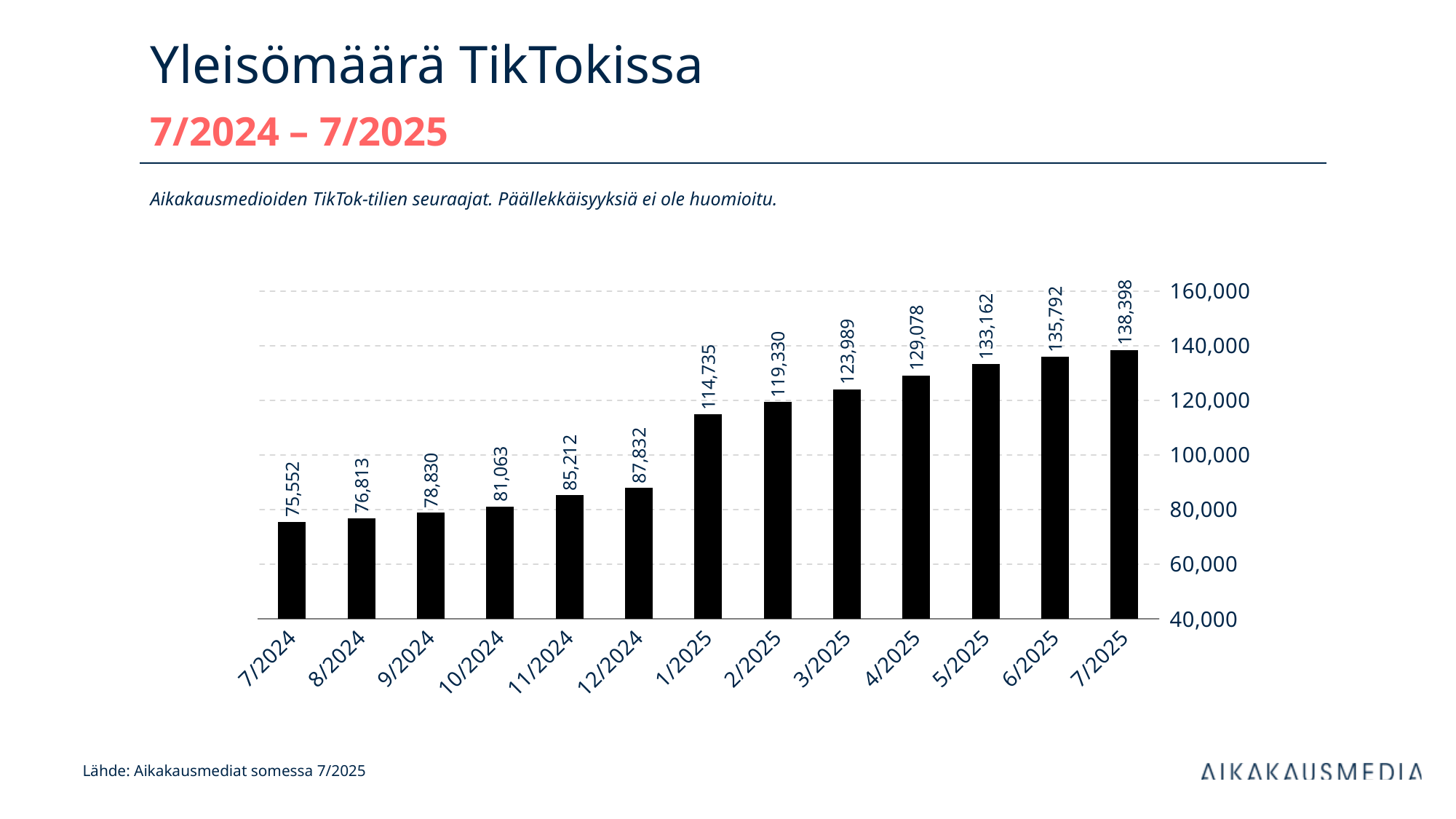
Which month has the highest value? 7/2025 What is the value for 4/2025? 129,078 What is the value for 7/2024? 75,552 What is the value for 1/2025? 114,735 Is the value for 3/2025 greater or less than 120,000? greater What is the difference between the values for 7/2025 and 7/2024? 62,846 Which month has the lowest value? 7/2024 Which is larger, the value for 11/2024 or the value for 2/2025? 2/2025 How many months are shown on the x axis? 13 What is the difference between the values for 1/2025 and 12/2024? 26,903 Do the values rise or fall from 7/2024 to 7/2025? rise What kind of chart is shown on the slide? bar chart